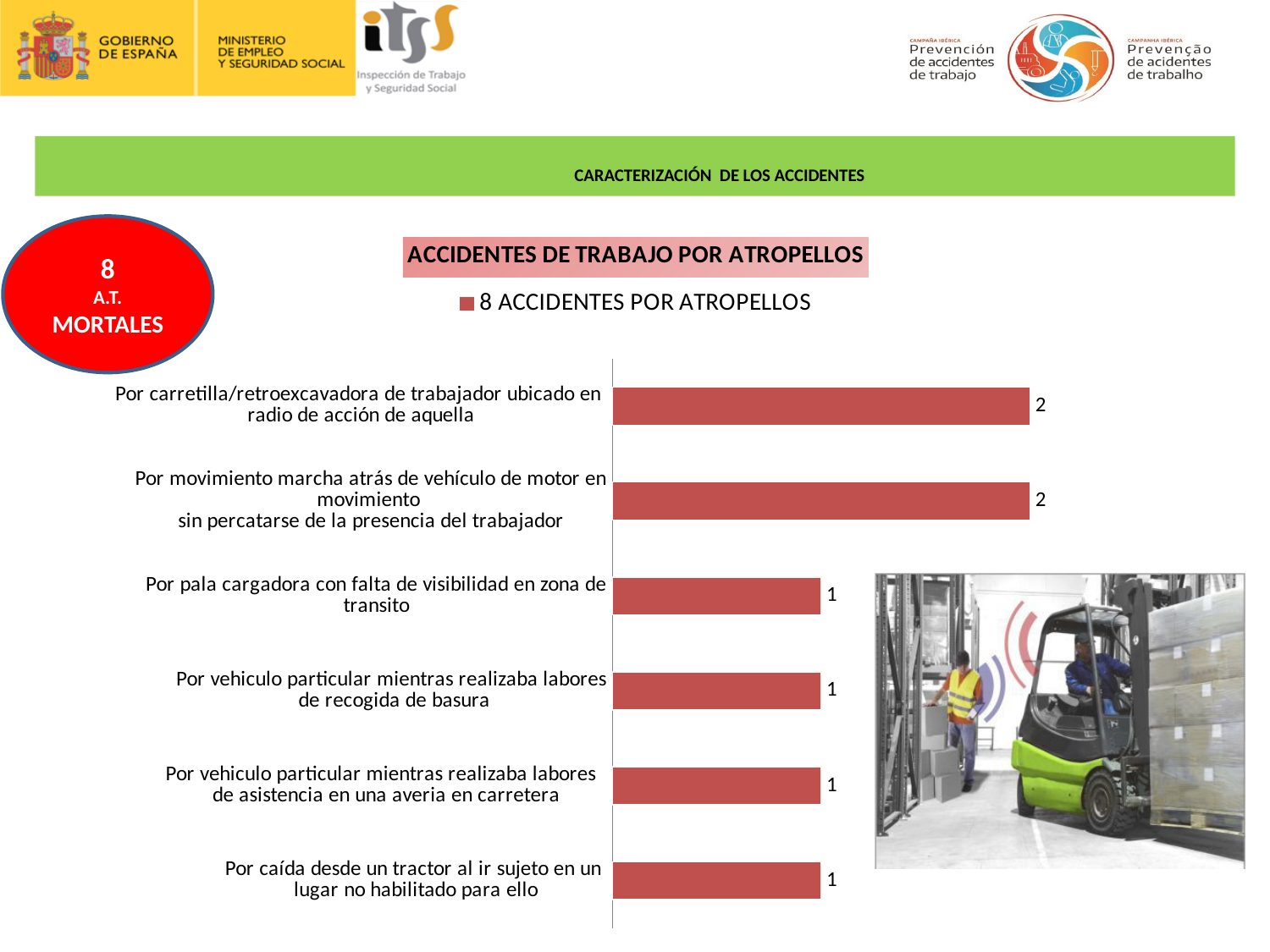
What is the value for "Por caída desde un tractor al ir sujeto en un lugar no habilitado para ello"? 1 What is the legend entry of the chart? 8 ACCIDENTES POR ATROPELLOS What is the difference between the value for "Por carretilla/retroexcavadora de trabajador ubicado en radio de acción de aquella" and the value for "Por vehiculo particular mientras realizaba labores de recogida de basura"? 1 What is the value for "Por carretilla/retroexcavadora de trabajador ubicado en radio de acción de aquella"? 2 What type of chart is shown on the slide? bar chart What is the value for "Por pala cargadora con falta de visibilidad en zona de transito"? 1 How many series does the chart legend list? 1 Which is larger: the value for "Por movimiento marcha atrás de vehículo de motor en movimiento sin percatarse de la presencia del trabajador" or the value for "Por vehiculo particular mientras realizaba labores de asistencia en una avería en carretera"? Por movimiento marcha atrás de vehículo de motor en movimiento sin percatarse de la presencia del trabajador How many categories does the bar chart show? 6 What is the value for "Por movimiento marcha atrás de vehículo de motor en movimiento sin percatarse de la presencia del trabajador"? 2 What is the title of the chart? ACCIDENTES DE TRABAJO POR ATROPELLOS What is the total of all the values shown in the bar chart? 8